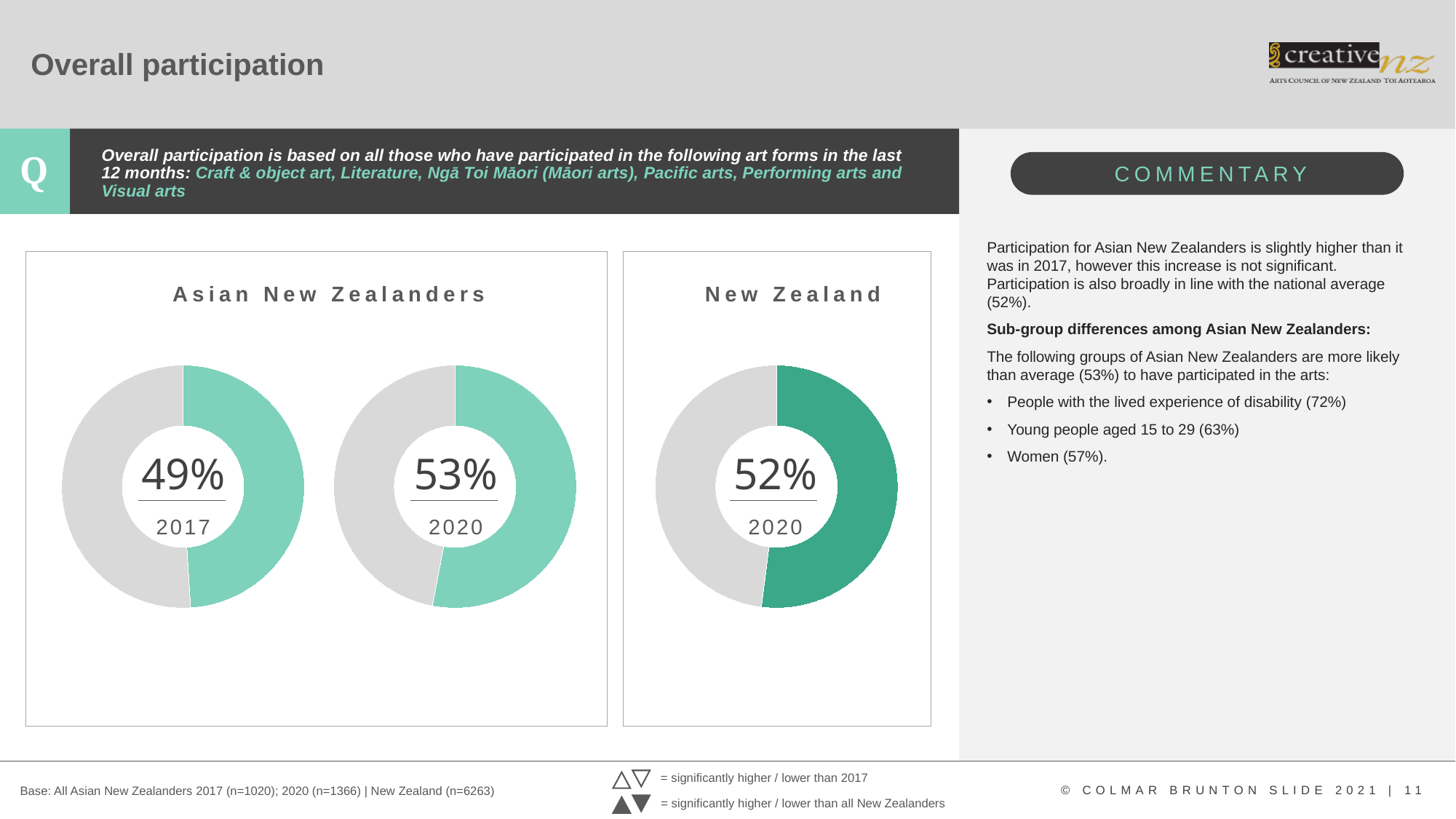
In the Asian New Zealanders chart, what is the participation value shown for 2020? 53% In the New Zealand chart, what is the participation value shown for 2020? 52% How many donut charts are shown in the Asian New Zealanders panel? 2 In the Asian New Zealanders chart, does participation rise or fall from 2017 to 2020? rise What kind of chart is used to show the participation values on this slide? Donut (pie) chart In the Asian New Zealanders chart, which year has the lower participation value? 2017 Is the 2020 value for Asian New Zealanders larger or smaller than the 2020 value for New Zealand? larger In the Asian New Zealanders chart, which year has the higher participation value? 2020 In the Asian New Zealanders chart, what is the difference between the 2020 and 2017 values? 4 percentage points In the Asian New Zealanders chart, what is the participation value shown for 2017? 49% What is the difference between the Asian New Zealanders 2020 value and the New Zealand 2020 value? 1 percentage point What is the title of the chart panel on the right? New Zealand